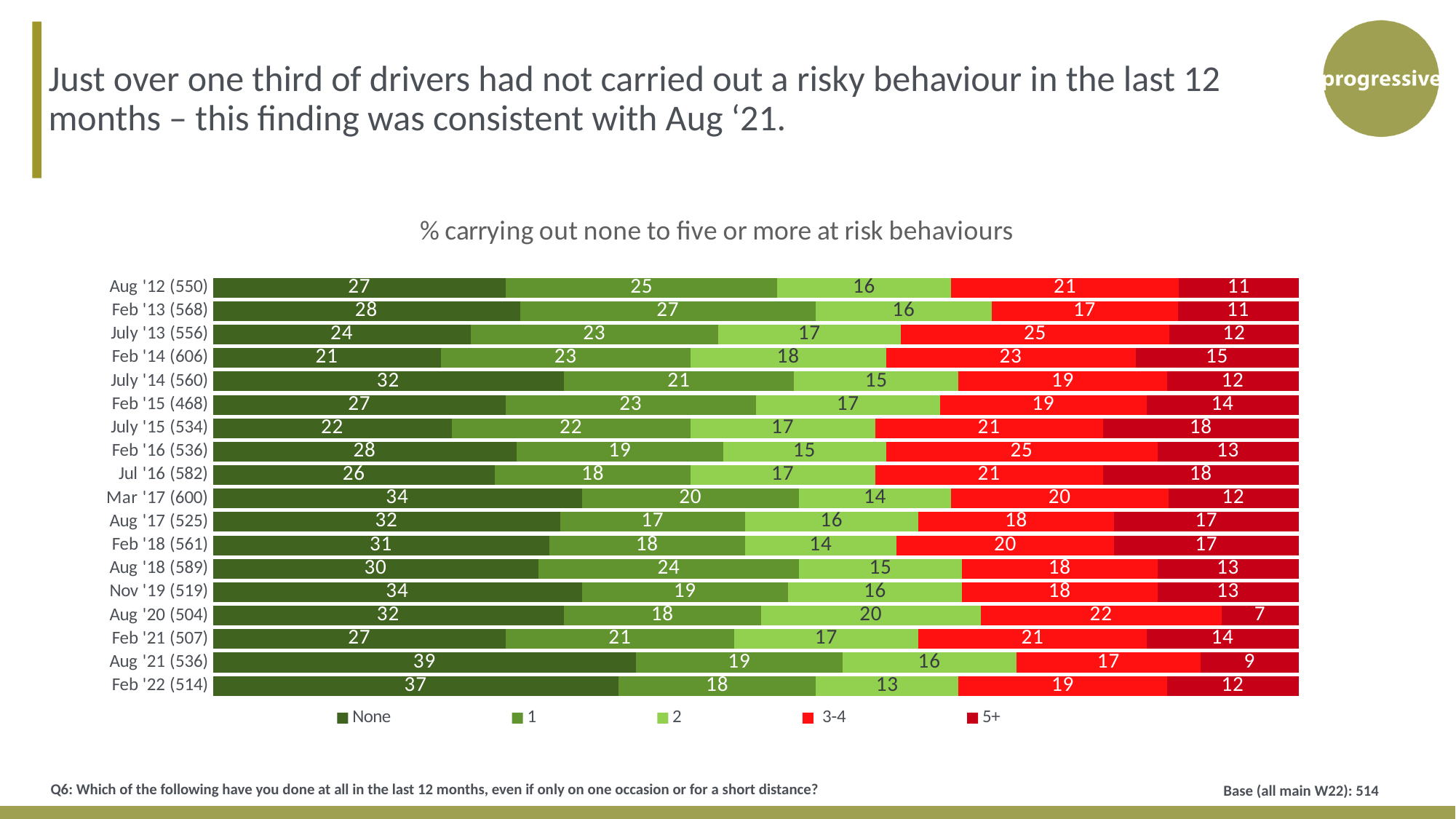
What is the value for '5+' in July '15 (534)? 18 What is the title of the chart? % carrying out none to five or more at risk behaviours What is the difference between the 'None' values for Aug '21 (536) and Feb '22 (514)? 2 What is the value for '3-4' in Aug '20 (504)? 22 How many survey waves (categories) are plotted on the chart? 18 What type of chart is shown on the slide? Stacked bar chart Which survey wave has the lowest value for '5+'? Aug '20 (504) Which is larger: the '3-4' value for July '13 (556) or for Aug '12 (550)? July '13 (556) Which survey wave has the lowest value for 'None'? Feb '14 (606) Which survey wave has the highest value for 'None'? Aug '21 (536) What is the value for 'None' in Feb '22 (514)? 37 How many series does the legend list? 5